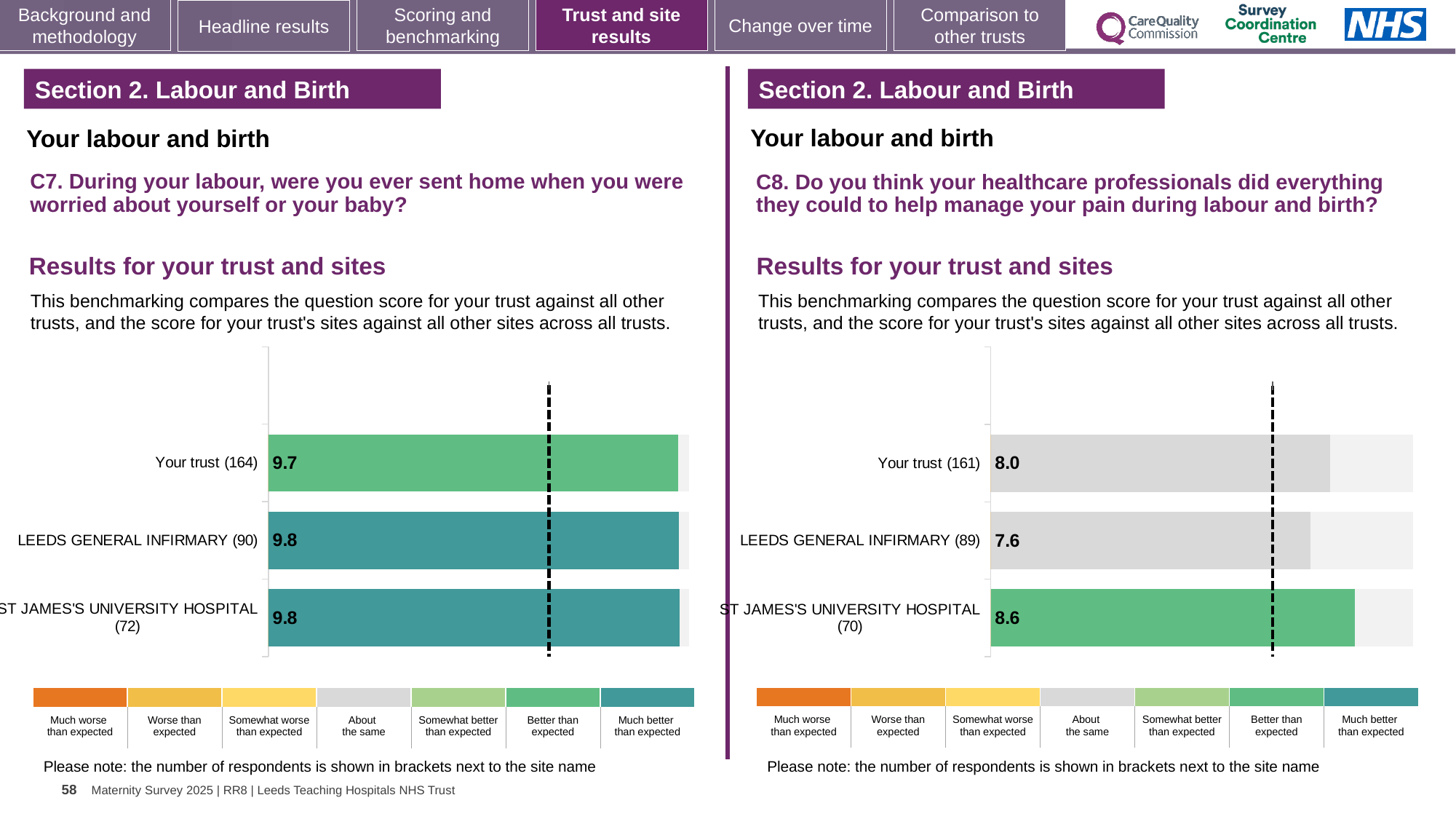
In the C7 chart on the left, what is the score for Your trust (164)? 9.7 In the C7 chart on the left, which bar has the lowest score? Your trust (164) How many bars are plotted in the C7 chart on the left? 3 In the C8 chart on the right, which benchmark category does the colour of the ST JAMES'S UNIVERSITY HOSPITAL (70) bar correspond to? Better than expected What type of chart is used for the C8 results on the right? Bar chart In the C8 chart on the right, what is the score for Your trust (161)? 8.0 In the C8 chart on the right, which site or trust has the lowest score? LEEDS GENERAL INFIRMARY (89) In the C8 chart on the right, which site or trust has the highest score? ST JAMES'S UNIVERSITY HOSPITAL (70) In the C8 chart on the right, what is the difference between the scores for ST JAMES'S UNIVERSITY HOSPITAL (70) and LEEDS GENERAL INFIRMARY (89)? 1.0 In the C8 chart on the right, what is the score for ST JAMES'S UNIVERSITY HOSPITAL (70)? 8.6 In the C8 chart on the right, which is larger: the score for Your trust (161) or for LEEDS GENERAL INFIRMARY (89)? Your trust (161) In the C7 chart on the left, what is the score for LEEDS GENERAL INFIRMARY (90)? 9.8